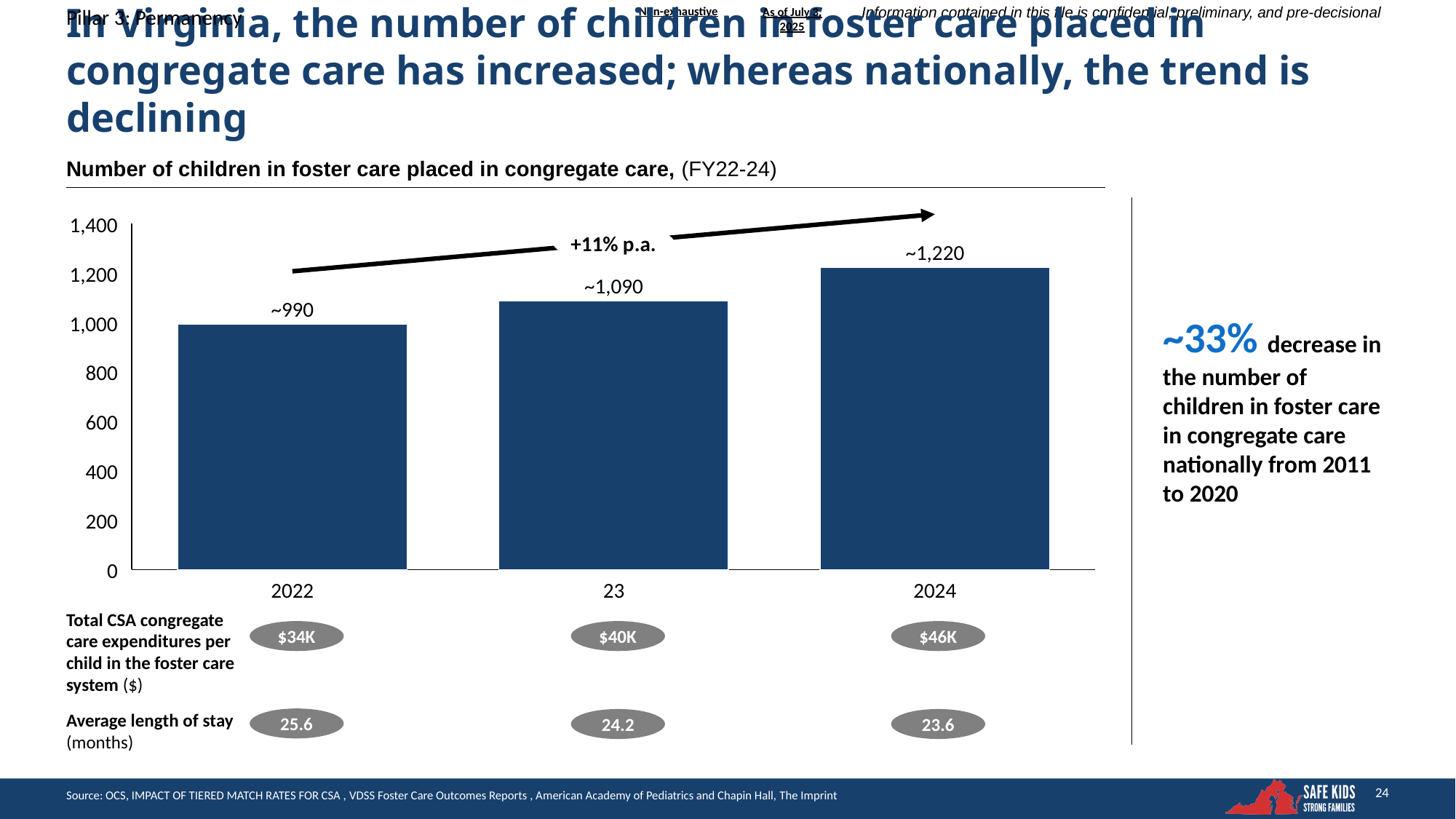
How many years (bars) are shown in the chart? 3 What annual growth rate is annotated on the chart? +11% p.a. What kind of chart is shown on the slide? bar chart Is the value for 2023 greater or less than 1,000? greater Is the value for 2022 greater or less than 1,000? less Is the value for 2023 greater or less than 1,200? less Which is larger, the value for 2022 or the value for 2024? 2024 What is the title of the chart? Number of children in foster care placed in congregate care, (FY22-24) Which year has the highest number of children in foster care placed in congregate care? 2024 Do the values rise or fall from 2022 to 2024? rise Which year has the lowest number of children in foster care placed in congregate care? 2022